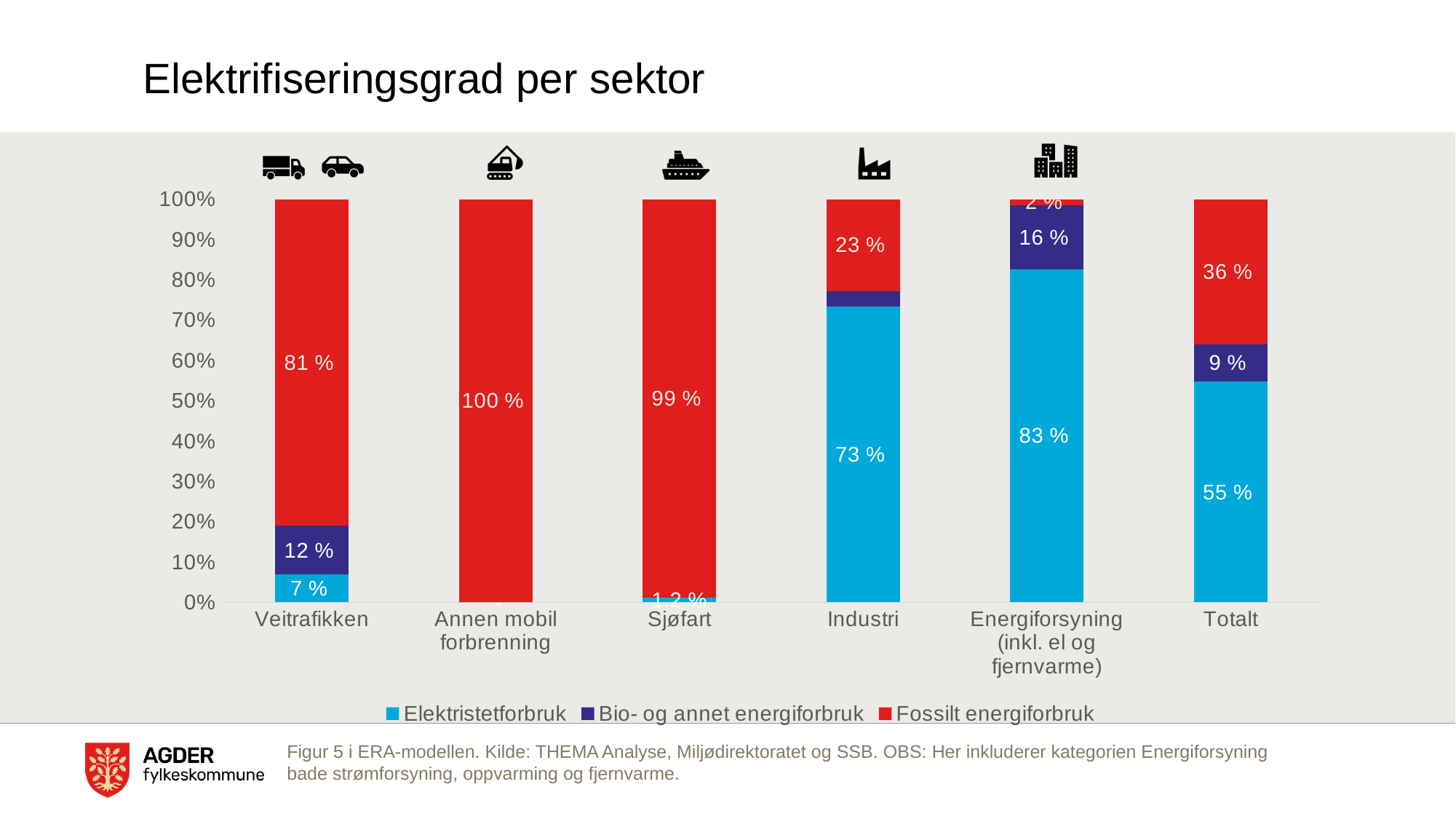
What is the Elektristetforbruk share for Sjøfart? 1,2 % Which sector has the highest Elektristetforbruk share? Energiforsyning (inkl. el og fjernvarme) What is the Fossilt energiforbruk share for Veitrafikken? 81 % What is the Bio- og annet energiforbruk share for Energiforsyning (inkl. el og fjernvarme)? 16 % What is the Elektristetforbruk share for Industri? 73 % Is the Elektristetforbruk share for Veitrafikken greater or less than 10%? less What is the difference between the Elektristetforbruk share for Energiforsyning (inkl. el og fjernvarme) and for Totalt? 28 % What kind of chart is shown on the slide? stacked bar chart Which is larger: the Fossilt energiforbruk share for Totalt or for Industri? Totalt How many series does the legend list? 3 How many sector categories are shown on the x axis? 6 Which sector has the highest Fossilt energiforbruk share? Annen mobil forbrenning